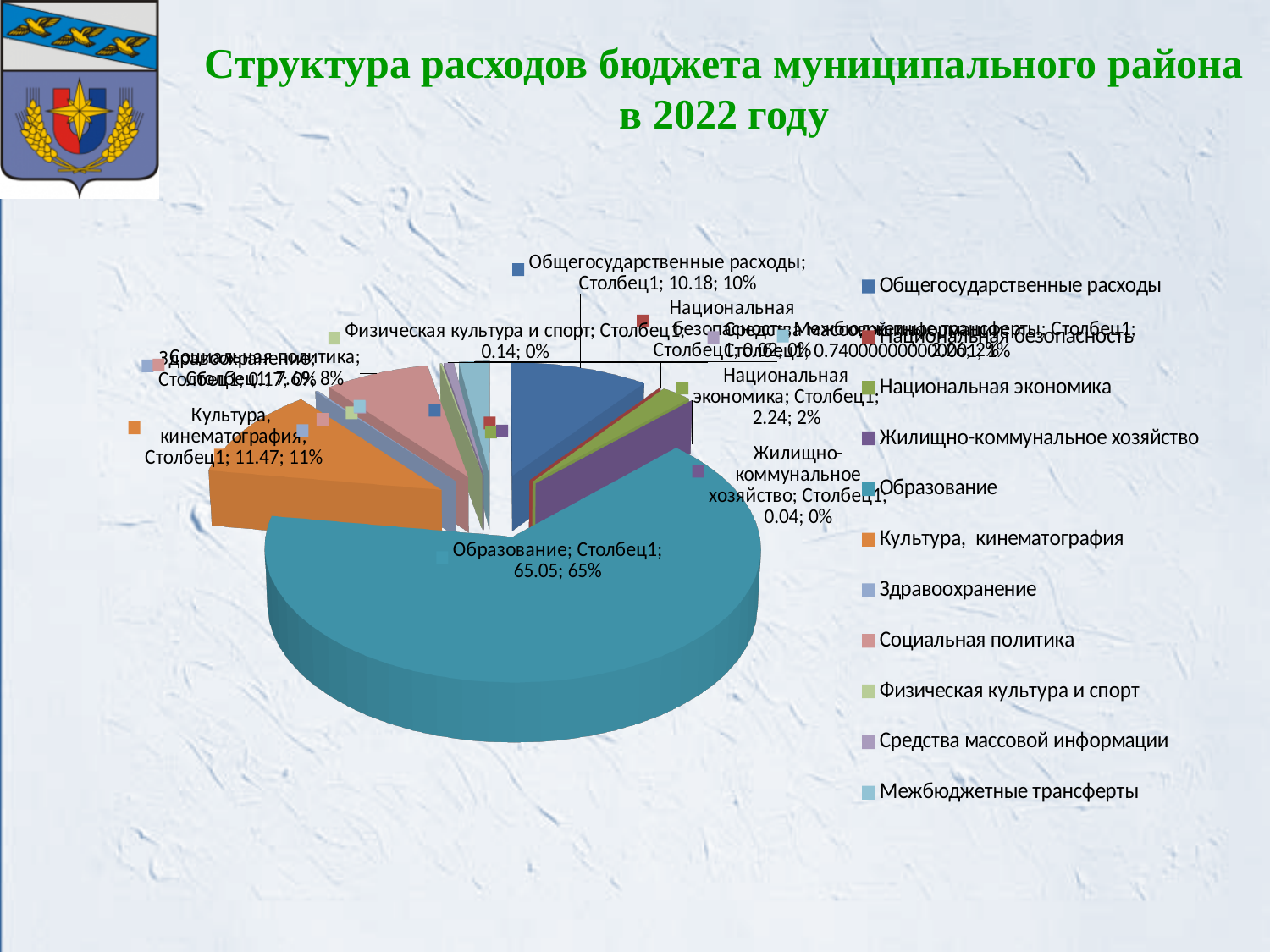
What is the value shown for Национальная экономика? 2.24 What is the difference between the values for Образование and Культура, кинематография? 53.58 How many categories does the legend of the pie chart list? 11 What share of the pie does Образование account for? 65% What is the value shown for Культура, кинематография? 11.47 What is the title of the chart on the slide? Структура расходов бюджета муниципального района в 2022 году What kind of chart is shown on the slide? pie chart Which is larger, the value for Культура, кинематография or the value for Общегосударственные расходы? Культура, кинематография Which category has the largest slice of the pie? Образование What is the value shown for Жилищно-коммунальное хозяйство? 0.04 What is the value shown for Образование? 65.05 What is the value shown for Общегосударственные расходы? 10.18